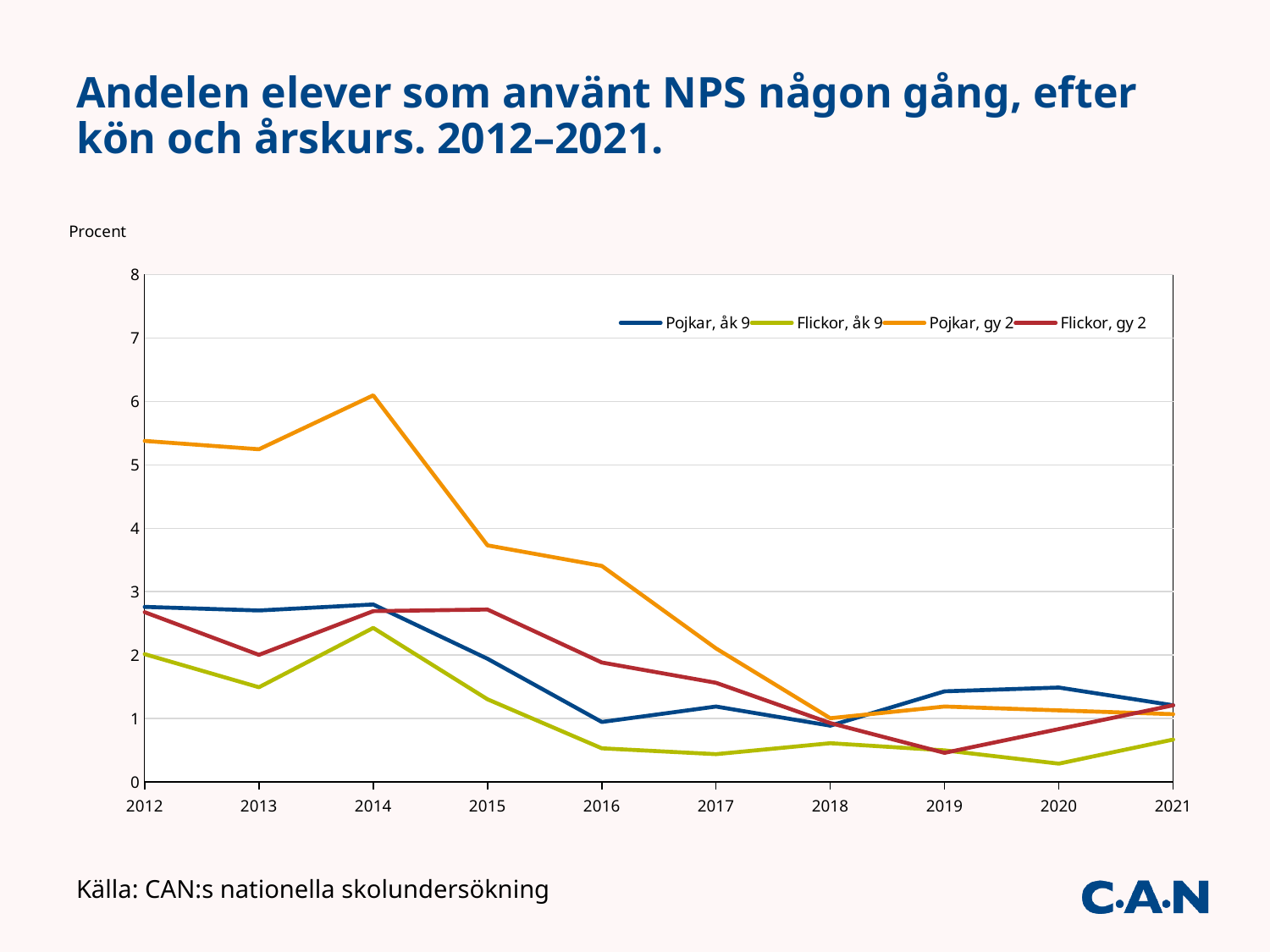
Is the value for Flickor, gy 2 in 2015 greater or less than 2? greater Which series has the highest value in 2014? Pojkar, gy 2 In which year does the Pojkar, gy 2 series reach its highest value? 2014 Is the value for Flickor, åk 9 in 2020 greater or less than 1? less Which is larger in 2016, Pojkar, gy 2 or Flickor, åk 9? Pojkar, gy 2 Is the value for Pojkar, gy 2 in 2012 greater or less than 5? greater What kind of chart is shown on the slide? line chart How many years are shown on the x axis? 10 How many series does the legend list? 4 What unit is shown on the y axis label? Procent Does the Pojkar, gy 2 series rise or fall from 2014 to 2018? fall Which series has the lowest value in 2012? Flickor, åk 9